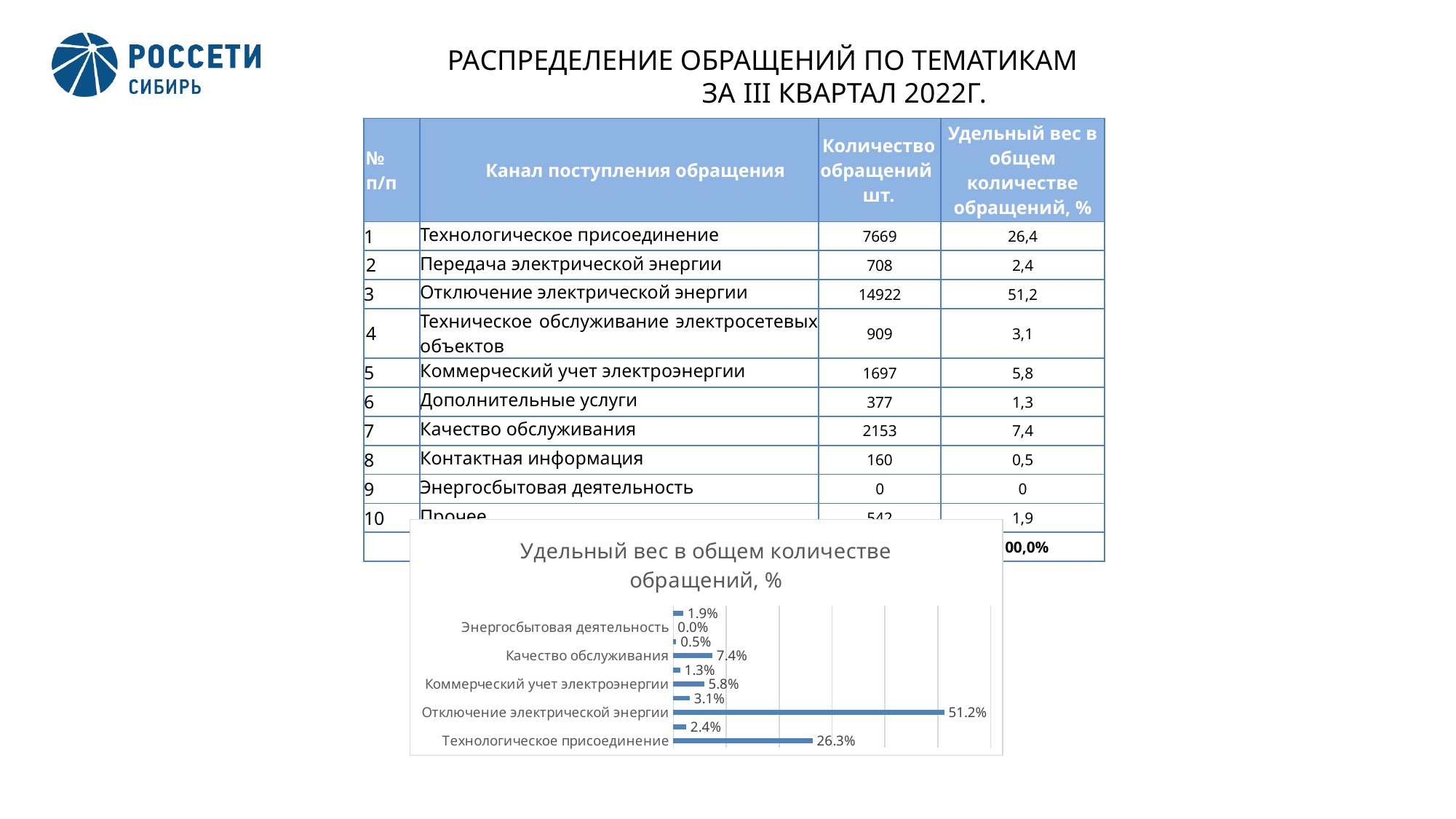
In the chart, what is the value for Технологическое присоединение? 26.3% In the chart, what is the value for Отключение электрической энергии? 51.2% Which category has the highest value in the chart? Отключение электрической энергии How many bars are plotted in the chart? 10 In the chart, what is the value for Энергосбытовая деятельность? 0.0% In the chart, what is the value for Коммерческий учет электроэнергии? 5.8% In the chart, what is the difference between the values for Отключение электрической энергии and Технологическое присоединение? 24.9% What is the title of the chart on the slide? Удельный вес в общем количестве обращений, % Which category has the lowest value in the chart? Энергосбытовая деятельность What kind of chart is shown on the slide? Bar chart In the chart, which is larger: the value for Качество обслуживания or the value for Коммерческий учет электроэнергии? Качество обслуживания In the chart, what is the value for Качество обслуживания? 7.4%